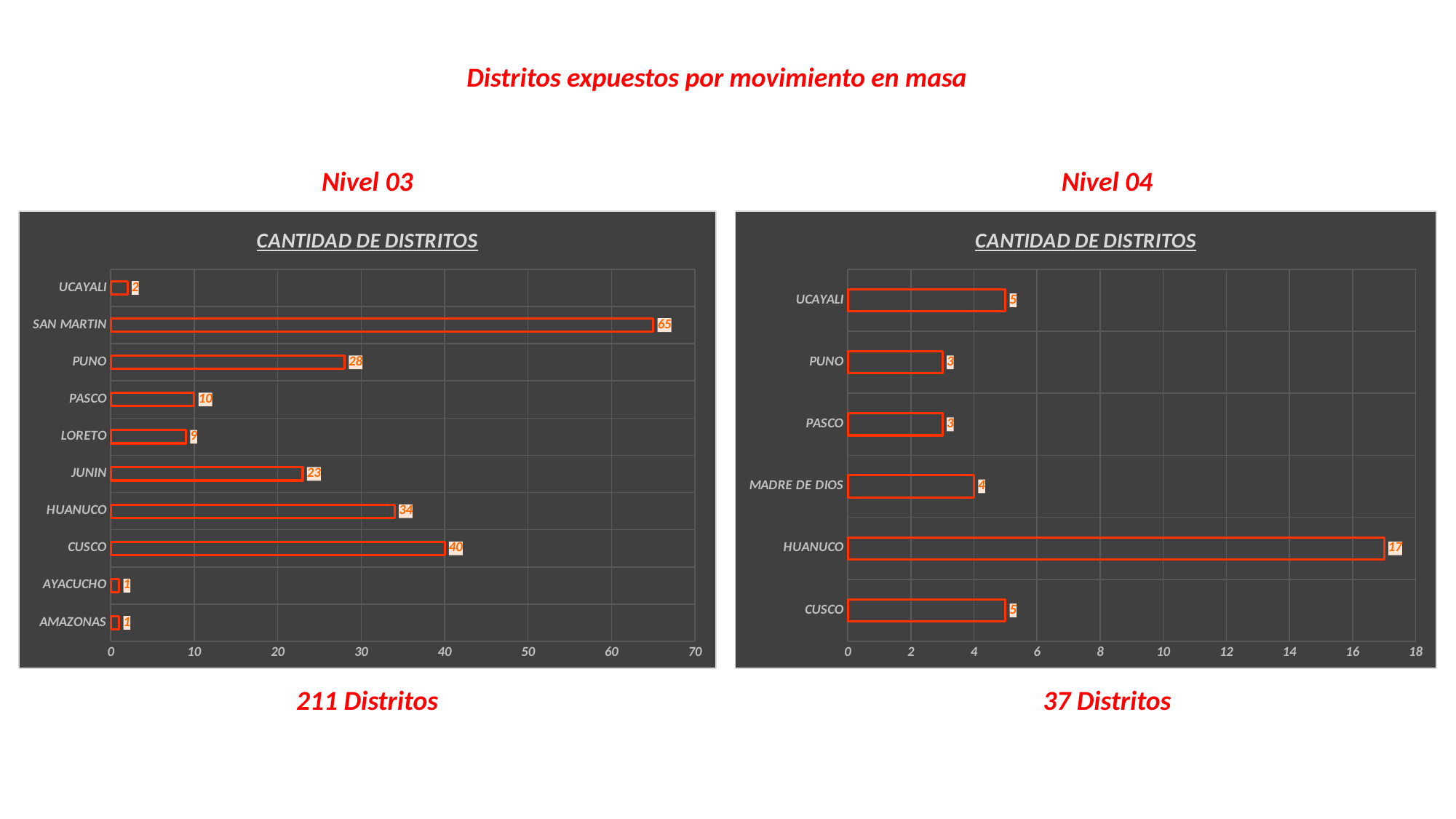
In the Nivel 04 chart, what is the value for MADRE DE DIOS? 4 In the Nivel 03 chart, which is larger, JUNIN or PASCO? JUNIN What type of chart is the Nivel 04 chart? Bar chart In the Nivel 03 chart, what is the value for HUANUCO? 34 In the Nivel 03 chart, is the value for HUANUCO greater or less than 30? greater How many categories are shown in the Nivel 04 chart? 6 In the Nivel 04 chart, what is the difference between HUANUCO and CUSCO? 12 How many categories are shown in the Nivel 03 chart? 10 In the Nivel 03 chart, which category has the highest value? SAN MARTIN In the Nivel 04 chart, which category has the highest value? HUANUCO In the Nivel 03 chart, what is the difference between CUSCO and PUNO? 12 In the Nivel 03 chart, what is the value for SAN MARTIN? 65